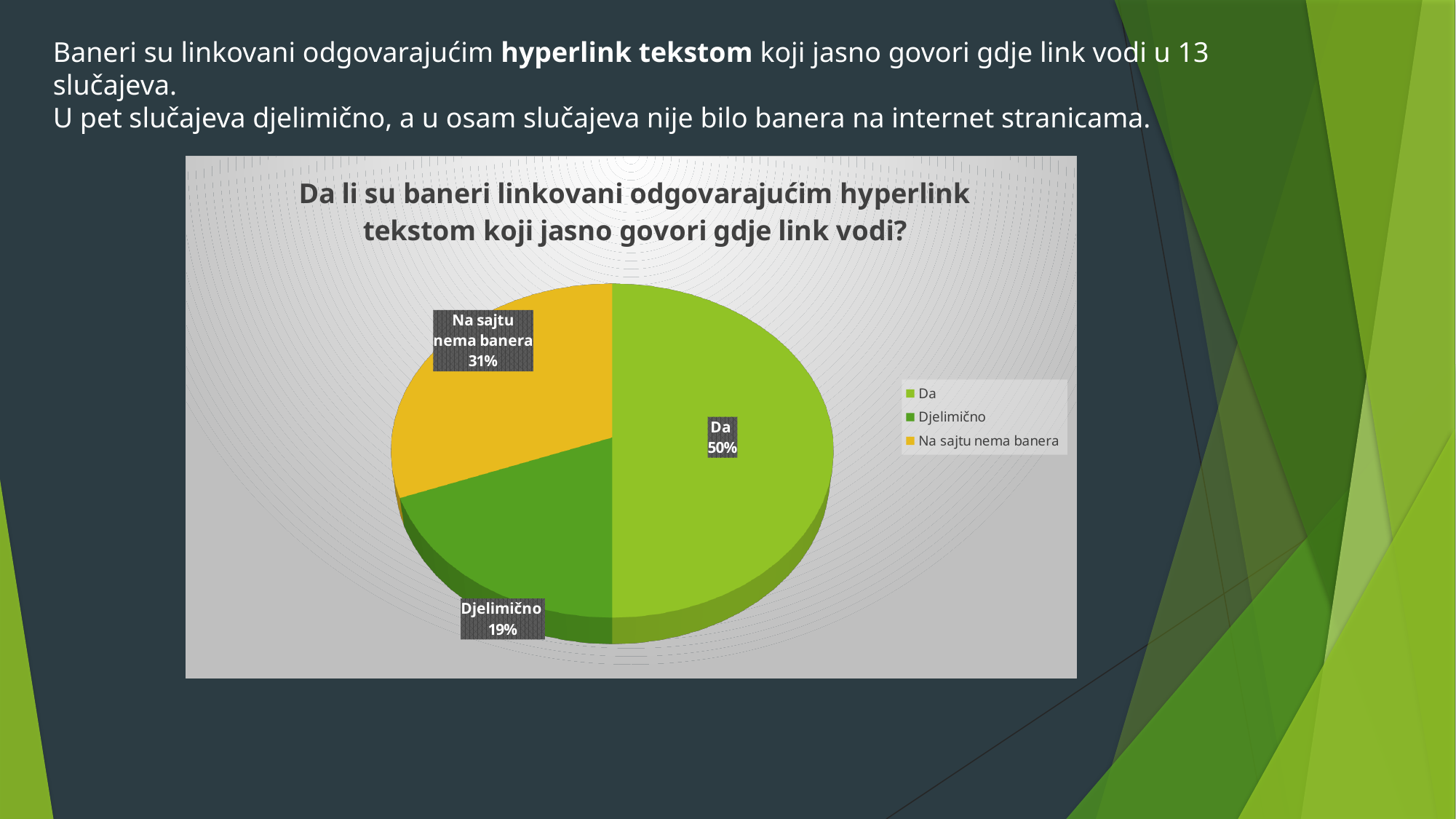
Which category has the smallest slice of the pie? Djelimično What is the difference in percentage points between the "Da" slice and the "Djelimično" slice? 31 How many slices does the pie chart have? 3 What share of the pie does the "Da" slice represent? 50% Which category has the largest slice of the pie? Da What colour is the "Na sajtu nema banera" slice? Yellow What is the difference in percentage points between the "Na sajtu nema banera" slice and the "Djelimično" slice? 12 What kind of chart is shown on the slide? Pie chart What share of the pie does the "Djelimično" slice represent? 19% Which is larger, the "Na sajtu nema banera" slice or the "Djelimično" slice? Na sajtu nema banera How many entries does the legend list? 3 What share of the pie does the "Na sajtu nema banera" slice represent? 31%